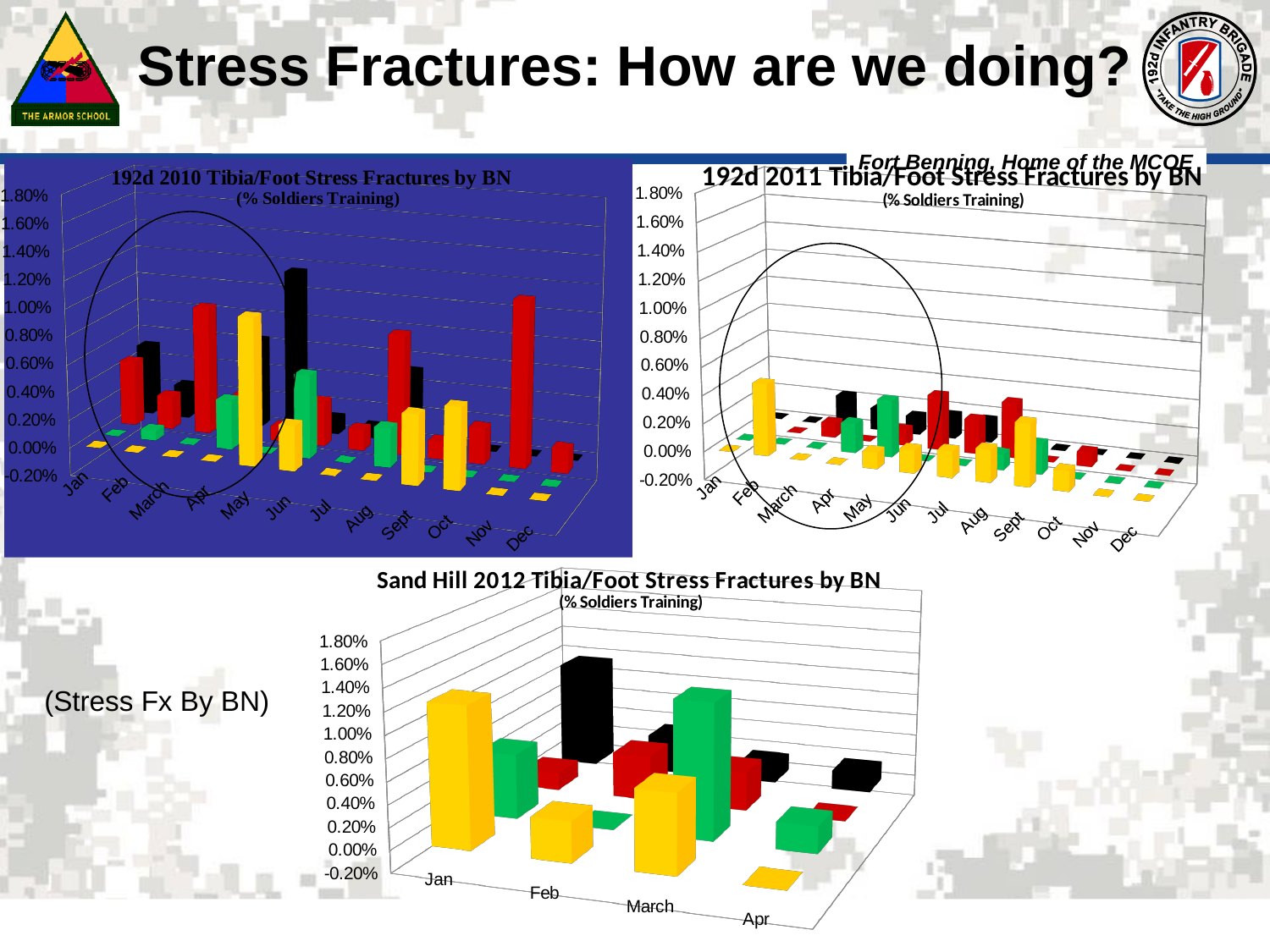
In the "Sand Hill 2012 Tibia/Foot Stress Fractures by BN" chart, is the tallest bar greater or less than 1.00%? greater What kind of chart is the "Sand Hill 2012 Tibia/Foot Stress Fractures by BN" chart? Bar chart What is the lowest value shown on the y axis of the "Sand Hill 2012 Tibia/Foot Stress Fractures by BN" chart? -0.20% What kind of chart is the "192d 2010 Tibia/Foot Stress Fractures by BN" chart? Bar chart What is the first month shown on the x axis of the "Sand Hill 2012 Tibia/Foot Stress Fractures by BN" chart? Jan How many months are shown on the x axis of the "Sand Hill 2012 Tibia/Foot Stress Fractures by BN" chart? 4 What is the highest value shown on the y axis of the "192d 2011 Tibia/Foot Stress Fractures by BN" chart? 1.80% What is the last month shown on the x axis of the "Sand Hill 2012 Tibia/Foot Stress Fractures by BN" chart? Apr How many charts are shown on the slide? 3 How many months are shown on the x axis of the "192d 2010 Tibia/Foot Stress Fractures by BN" chart? 12